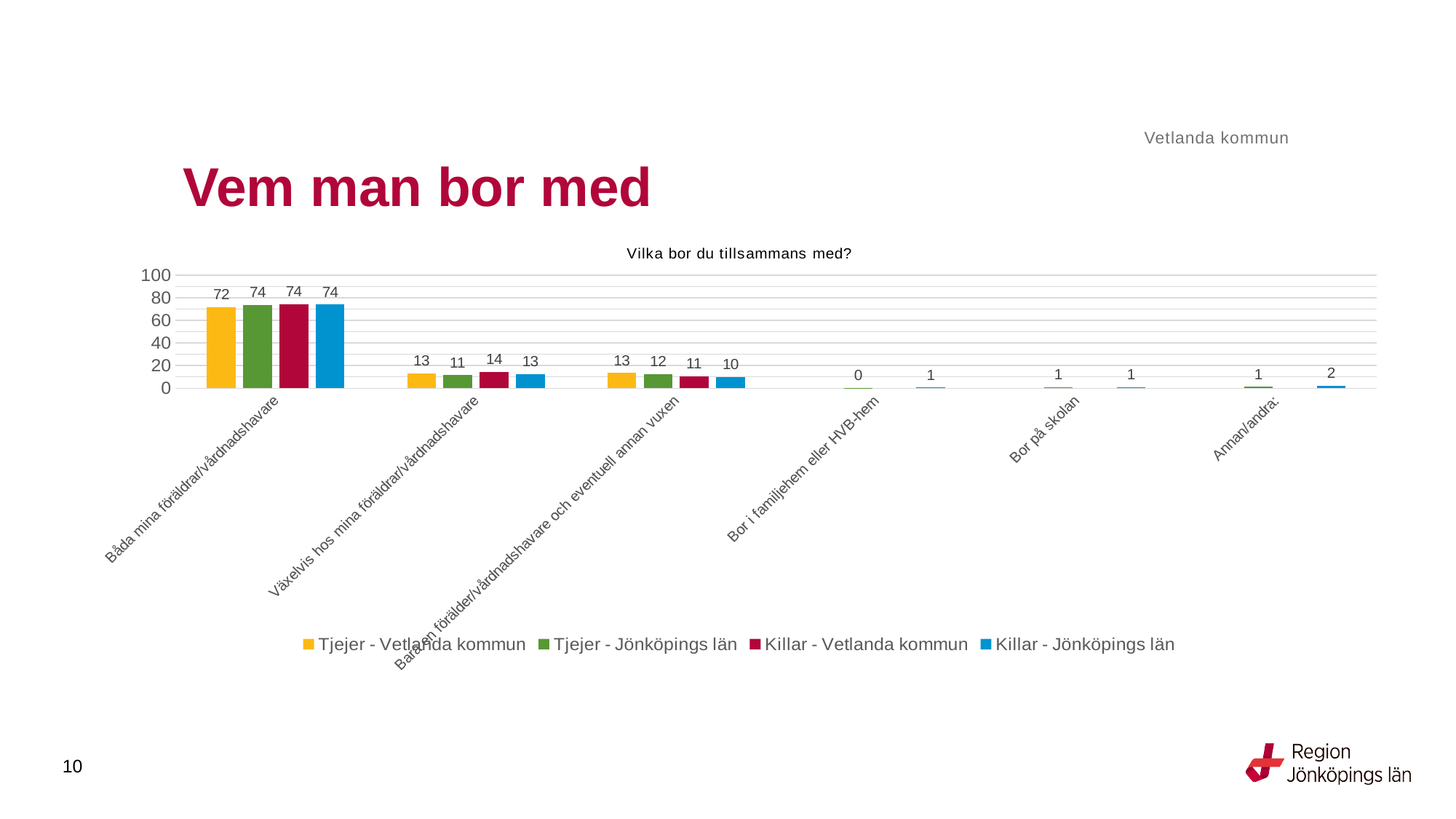
What is the value for Killar - Jönköpings län in the category 'Bara en förälder/vårdnadshavare och eventuell annan vuxen'? 10 Which series has the lowest value in the category 'Båda mina föräldrar/vårdnadshavare'? Tjejer - Vetlanda kommun How many categories are shown on the x axis of the chart? 6 In the category 'Växelvis hos mina föräldrar/vårdnadshavare', which is larger: Tjejer - Vetlanda kommun or Tjejer - Jönköpings län? Tjejer - Vetlanda kommun What is the value for Killar - Jönköpings län in the category 'Annan/andra:'? 2 In the category 'Båda mina föräldrar/vårdnadshavare', how much higher is Tjejer - Jönköpings län than Tjejer - Vetlanda kommun? 2 What is the value for Killar - Vetlanda kommun in the category 'Växelvis hos mina föräldrar/vårdnadshavare'? 14 Which series has the highest value in the category 'Växelvis hos mina föräldrar/vårdnadshavare'? Killar - Vetlanda kommun What kind of chart is shown on the slide? Bar chart How many series does the legend list? 4 What is the value for Tjejer - Vetlanda kommun in the category 'Båda mina föräldrar/vårdnadshavare'? 72 In the category 'Bara en förälder/vårdnadshavare och eventuell annan vuxen', what is the difference between Tjejer - Vetlanda kommun and Killar - Jönköpings län? 3